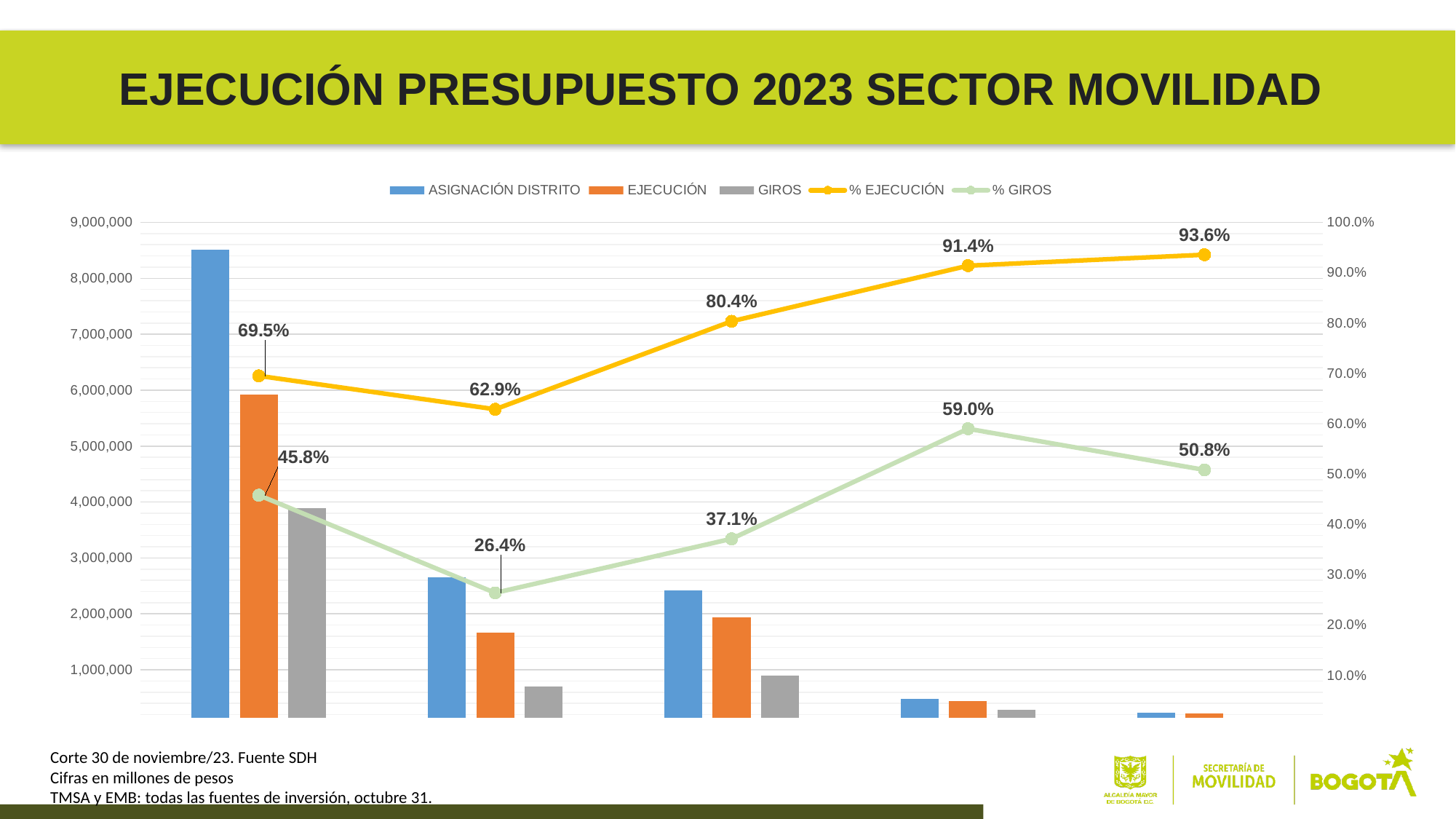
What is the lowest value on the % GIROS line? 26.4% What kind of chart is shown on the slide? Combined bar and line chart What is the % EJECUCIÓN value for the third category group from the left? 80.4% In the first (leftmost) category group, which bar is taller: ASIGNACIÓN DISTRITO or EJECUCIÓN? ASIGNACIÓN DISTRITO What is the difference between the % EJECUCIÓN values of the fifth and fourth category groups (93.6% and 91.4%)? 2.2 percentage points What is the highest value on the % EJECUCIÓN line? 93.6% What is the lowest value on the % EJECUCIÓN line? 62.9% How many category groups of bars are plotted along the x axis? 5 Does the % EJECUCIÓN line rise or fall from the second category group to the fifth? Rises Is the ASIGNACIÓN DISTRITO bar for the first (leftmost) category group greater or less than 8,000,000? greater How many series does the legend list? 5 What is the highest value on the % GIROS line? 59.0%